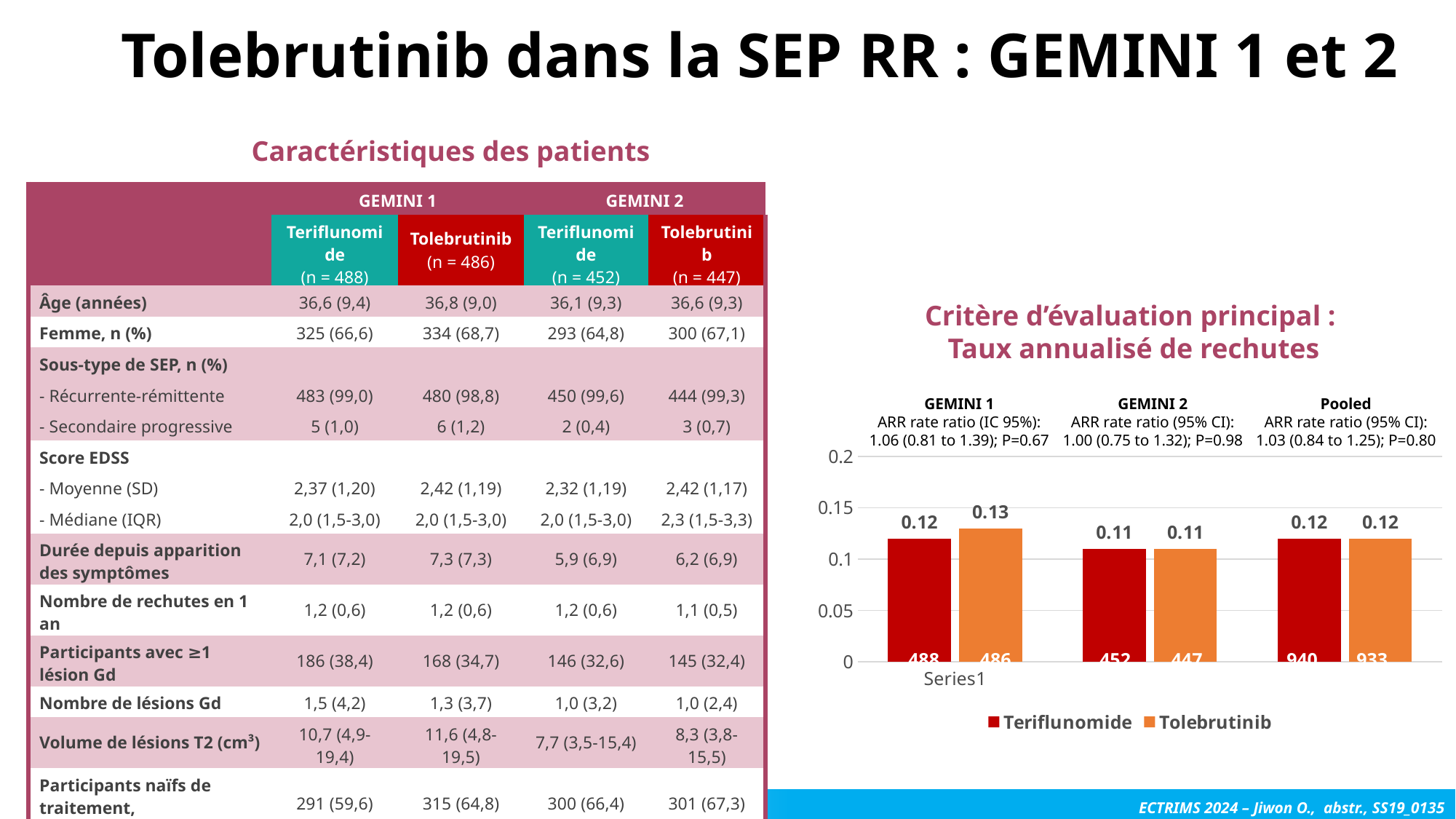
How many series does the legend of the annualised relapse rate chart list? 2 Which colour represents Teriflunomide in the chart legend? red What is the annualised relapse rate for Teriflunomide in GEMINI 2? 0.11 In GEMINI 1, which has the higher annualised relapse rate, Teriflunomide or Tolebrutinib? Tolebrutinib What is the annualised relapse rate for Tolebrutinib in the Pooled group? 0.12 What is the difference between the Tolebrutinib and Teriflunomide annualised relapse rates in GEMINI 1? 0.01 Which bar shows the highest annualised relapse rate in the chart? Tolebrutinib, GEMINI 1 How many study groups (categories) are shown on the x axis of the annualised relapse rate chart? 3 What type of chart is used to show the annualised relapse rate? bar chart What is the annualised relapse rate for Tolebrutinib in GEMINI 1? 0.13 Is the annualised relapse rate for Teriflunomide in the Pooled group greater or less than 0.15? less What number of participants is printed at the base of the Tolebrutinib bar in the Pooled group? 933